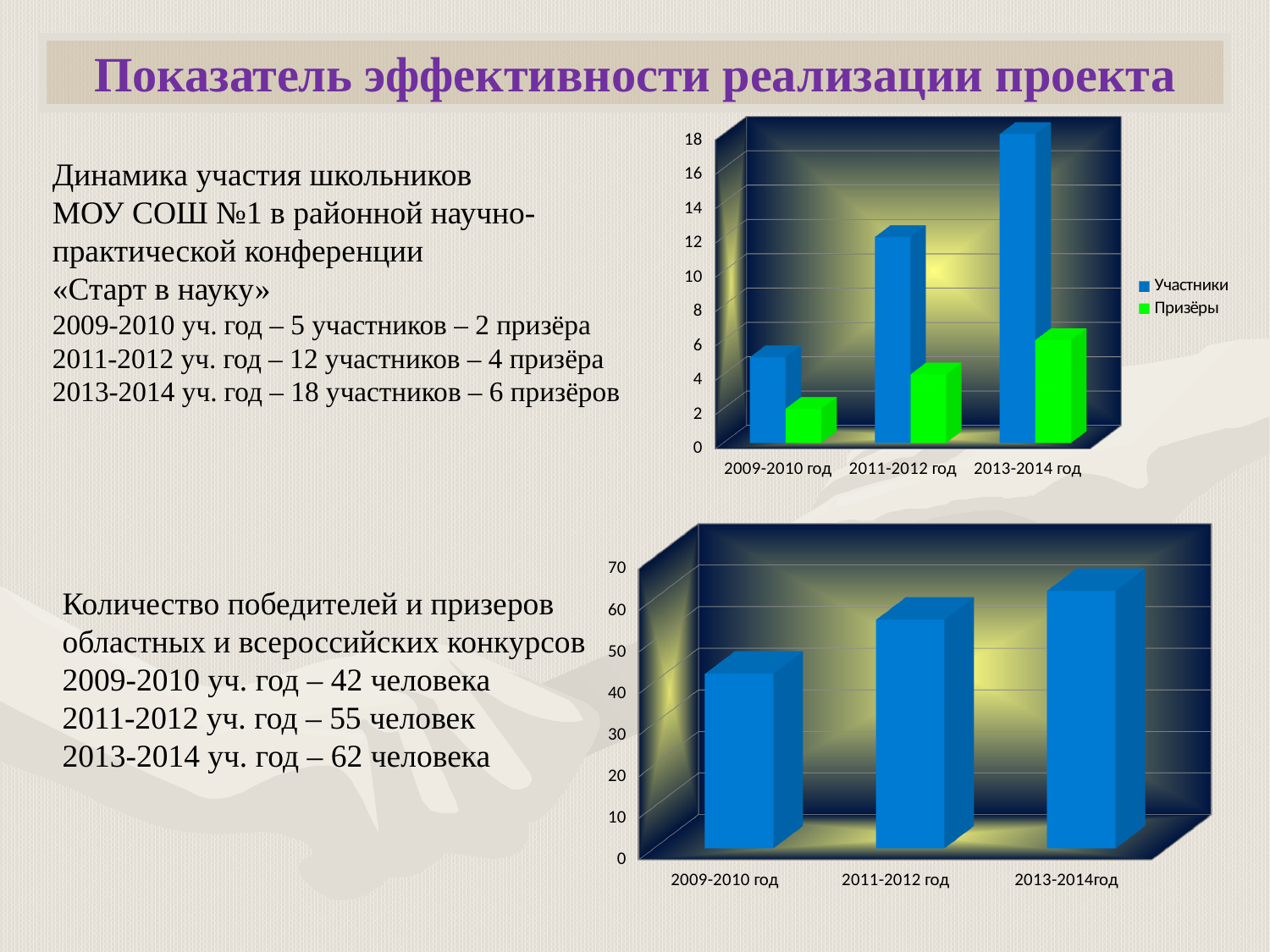
On the bottom chart, is the value for 2013-2014год greater or less than 60? greater On the top chart, how many categories are shown on the x axis? 3 On the top chart, which year has the lowest value for Призёры? 2009-2010 год On the top chart, what are the two legend entries? Участники, Призёры On the top chart, what is the value for Призёры in 2011-2012 год? 4 On the top chart, how many series does the legend list? 2 On the top chart, do the values for Участники rise or fall from 2009-2010 год to 2013-2014 год? rise What kind of chart is the bottom chart? bar chart On the bottom chart, is the value for 2009-2010 год greater or less than 50? less On the bottom chart, which category has the lowest value? 2009-2010 год On the top chart, which year has the highest value for Участники? 2013-2014 год On the top chart, what is the value for Участники in 2013-2014 год? 18